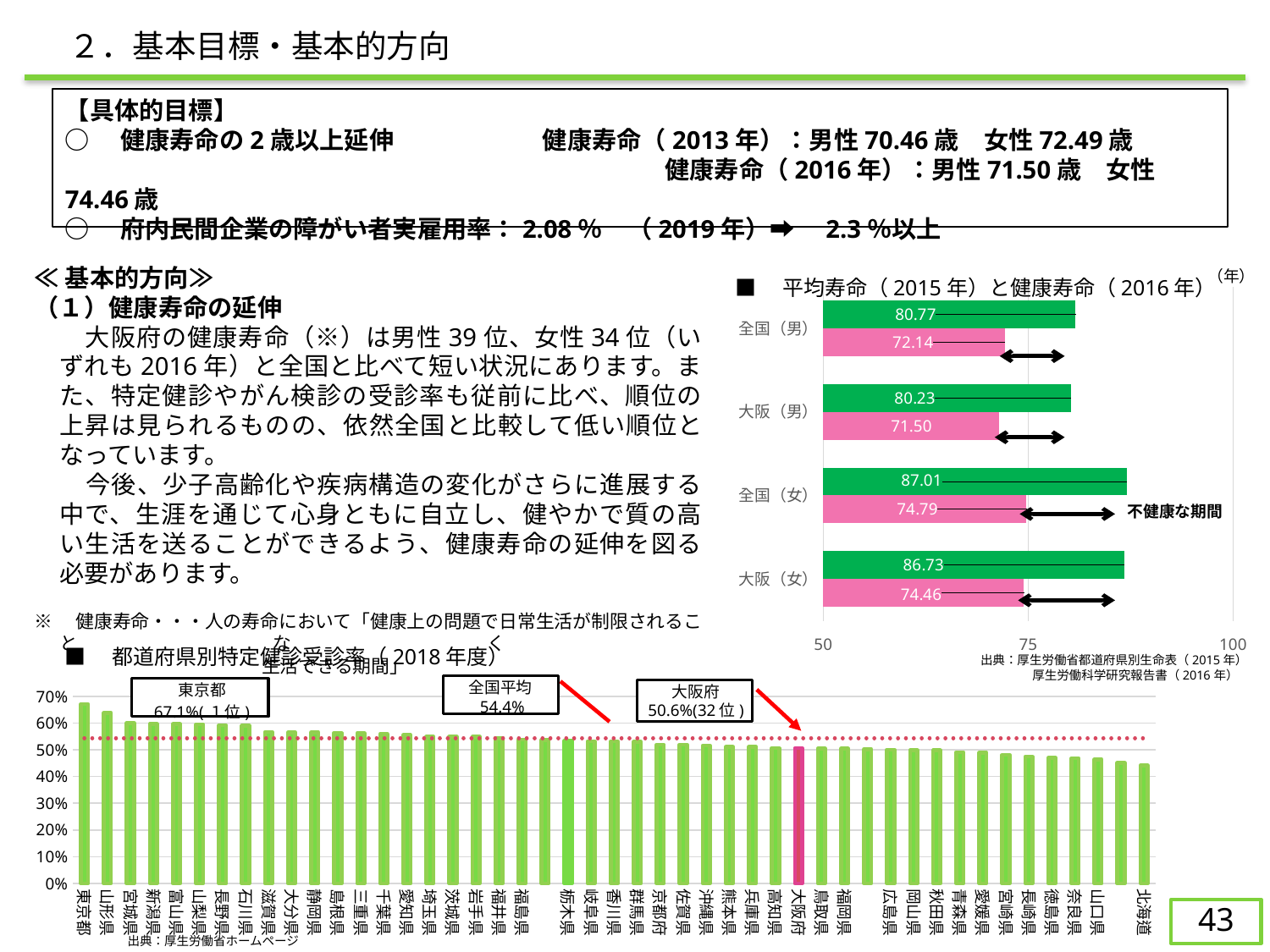
In the chart titled 平均寿命（2015年）と健康寿命（2016年）, what is the 平均寿命 value for 全国（男）? 80.77 In the chart titled 平均寿命（2015年）と健康寿命（2016年）, what is the 健康寿命 value for 大阪（女）? 74.46 In the chart titled 都道府県別特定健診受診率（2018年度）, what is the value for 東京都? 67.1% In the chart titled 平均寿命（2015年）と健康寿命（2016年）, which is larger: the 健康寿命 value for 全国（男） or for 大阪（男）? 全国（男） In the chart titled 平均寿命（2015年）と健康寿命（2016年）, which category has the lowest 健康寿命 value? 大阪（男） In the chart titled 平均寿命（2015年）と健康寿命（2016年）, how many categories are shown on the vertical axis? 4 In the chart titled 都道府県別特定健診受診率（2018年度）, is the value for 北海道 greater or less than 50%? less In the chart titled 平均寿命（2015年）と健康寿命（2016年）, what is the difference between the 平均寿命 and 健康寿命 values for 全国（女）? 12.22 What kind of chart is the chart titled 平均寿命（2015年）と健康寿命（2016年）? bar chart In the chart titled 都道府県別特定健診受診率（2018年度）, what is the value for 大阪府? 50.6% In the chart titled 平均寿命（2015年）と健康寿命（2016年）, what is the 健康寿命 value for 大阪（男）? 71.50 In the chart titled 平均寿命（2015年）と健康寿命（2016年）, which category has the highest 平均寿命 value? 全国（女）